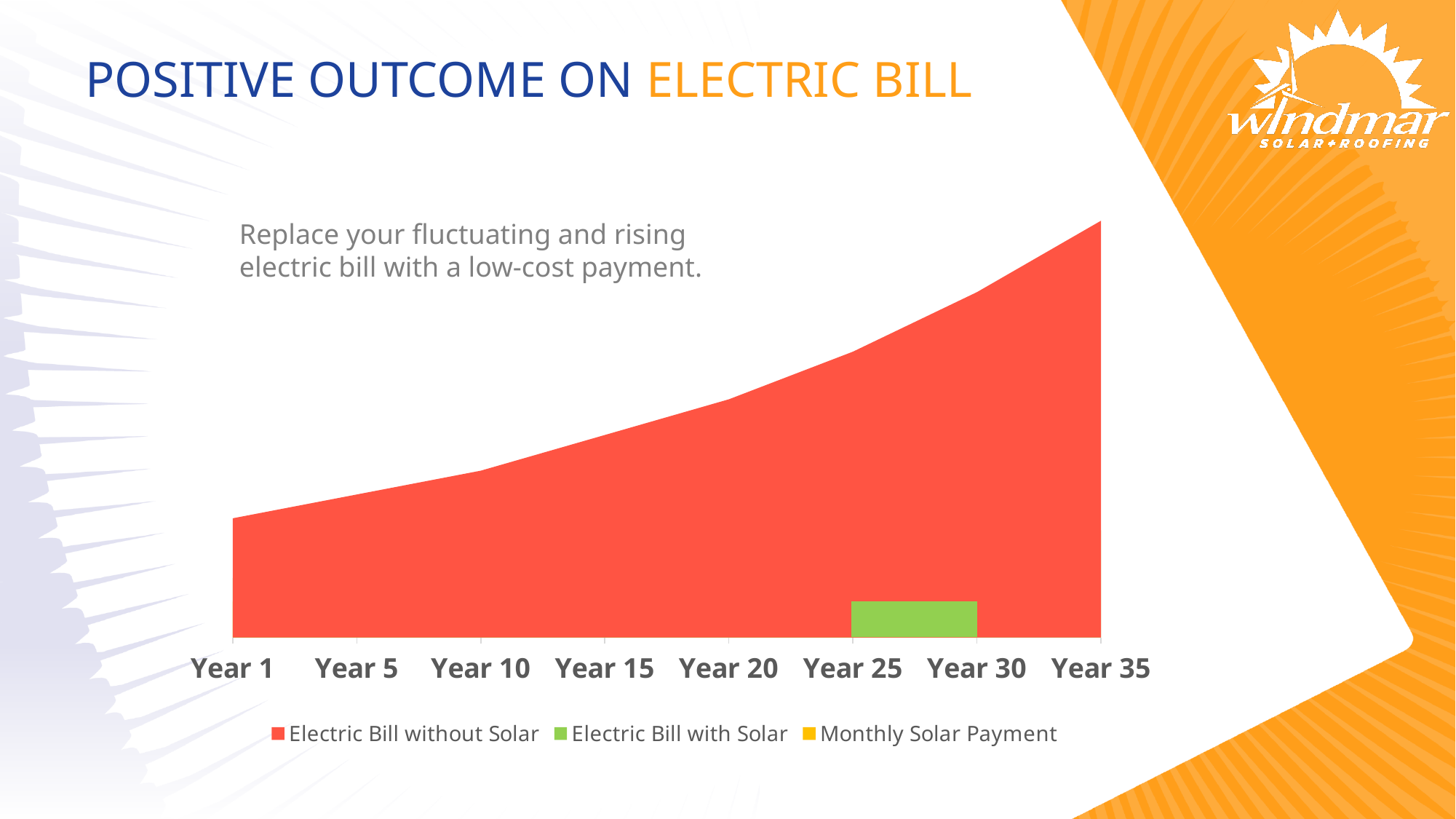
How many year categories are labelled on the x axis? 8 Which colour represents Electric Bill with Solar in the legend? Green What is the last category label on the x axis? Year 35 What is the first category label on the x axis? Year 1 Does the Electric Bill without Solar series rise or fall from Year 1 to Year 35? Rise What is the title of the slide containing the chart? POSITIVE OUTCOME ON ELECTRIC BILL Which is larger at Year 25: Electric Bill without Solar or Electric Bill with Solar? Electric Bill without Solar Which is larger for Electric Bill without Solar: the value at Year 35 or the value at Year 1? Year 35 At which year is the Electric Bill without Solar lowest? Year 1 How many series does the legend list? 3 At which year is the Electric Bill without Solar highest? Year 35 What kind of chart is shown on the slide? Area chart